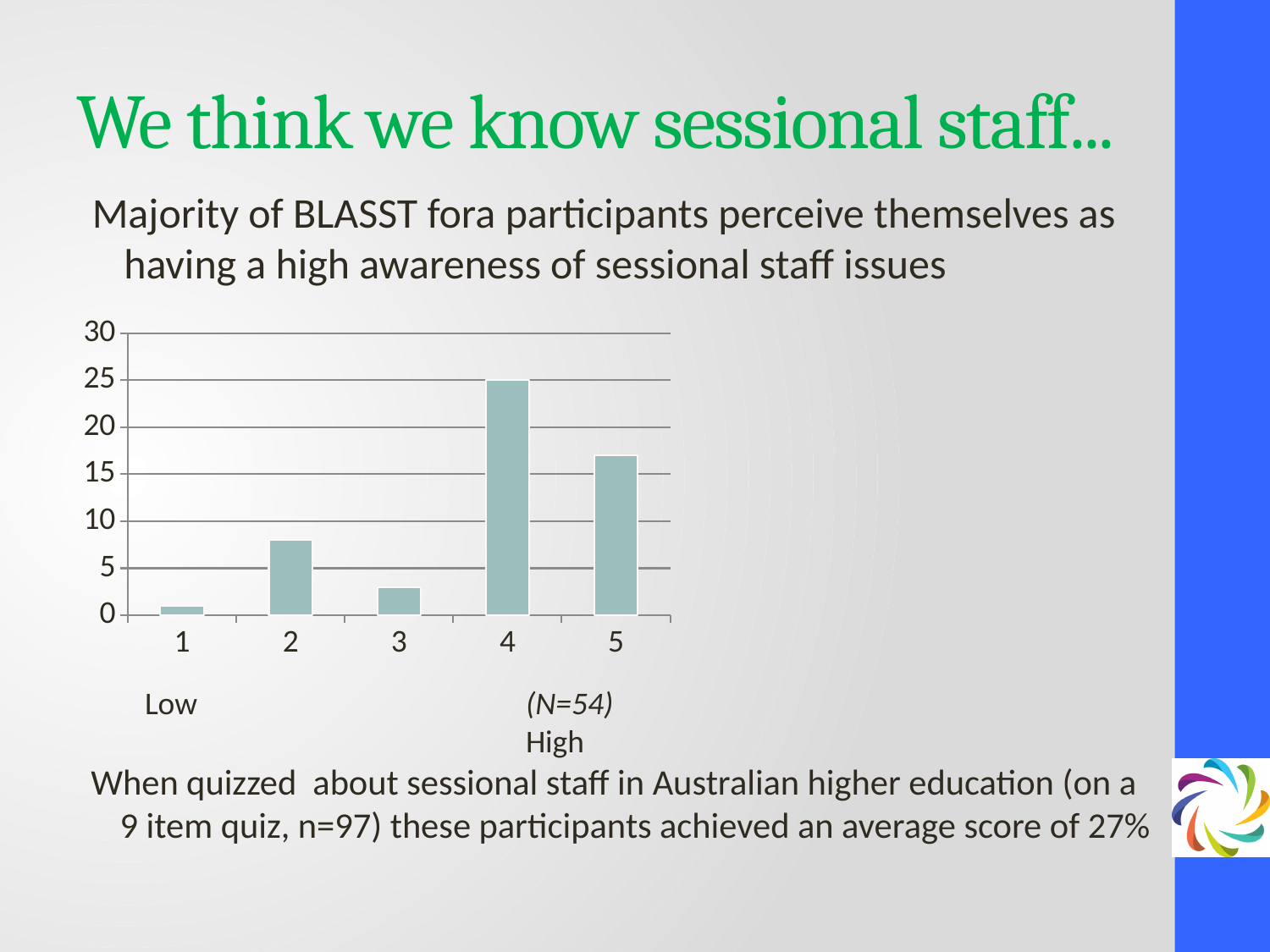
How many categories are shown on the x axis of the chart? 5 Is the value for category 5 greater or less than 20? less Is the value for category 3 greater or less than 5? less Is the value for category 5 greater or less than 15? greater What is the value for category 4 in the chart? 25 Which is larger, the value for category 4 or the value for category 5? 4 Which is larger, the value for category 2 or the value for category 3? 2 What kind of chart is shown on the slide? bar chart What sample size (N) is noted beneath the chart? N=54 Which category has the lowest bar in the chart? 1 Which category has the highest bar in the chart? 4